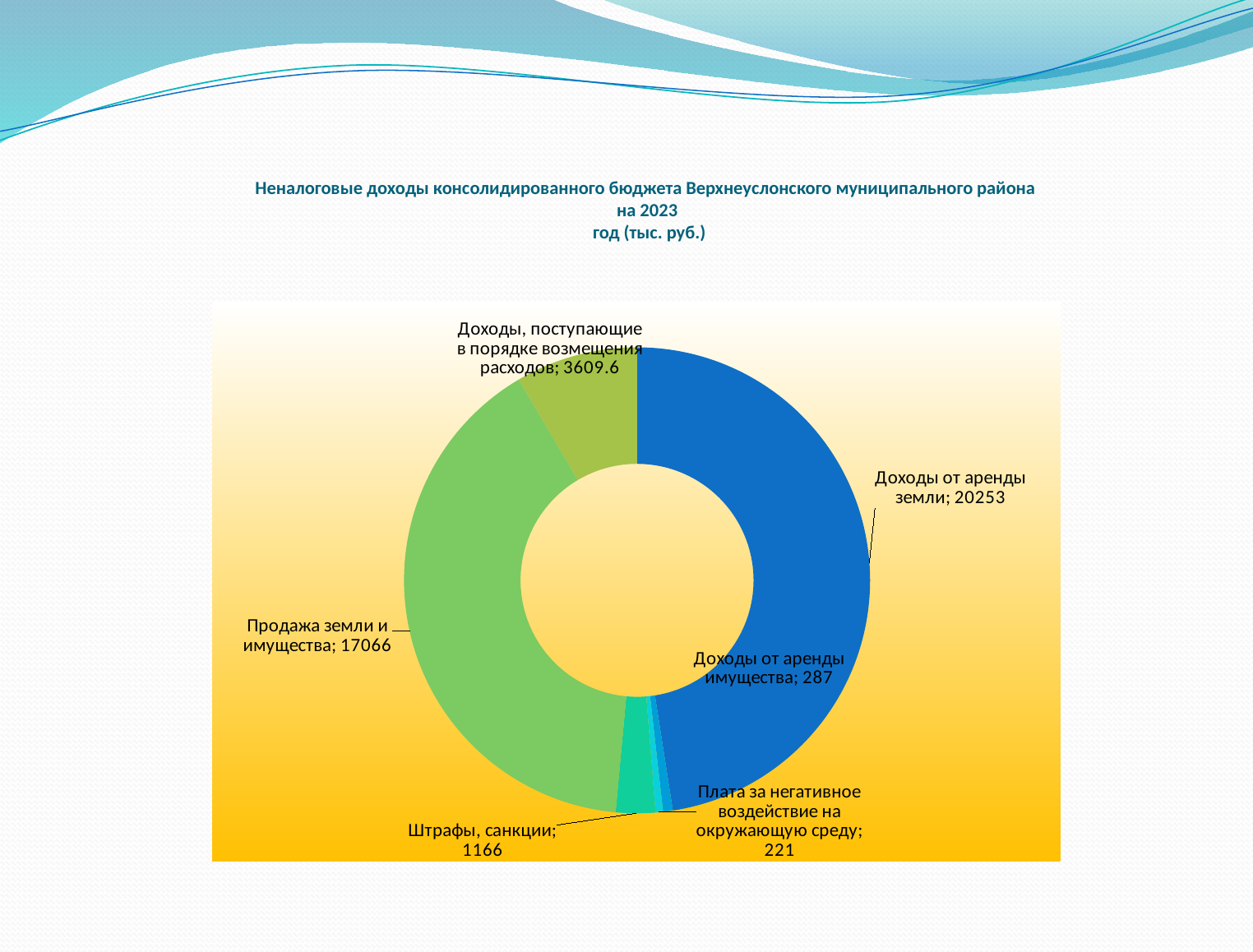
What is the value for Доходы, поступающие в порядке возмещения расходов? 3609.6 How many categories are shown in the chart? 6 What is the value for Продажа земли и имущества? 17066 What is the value for Плата за негативное воздействие на окружающую среду? 221 Which category has the highest value? Доходы от аренды земли What is the value for Доходы от аренды земли? 20253 What is the value for Штрафы, санкции? 1166 What kind of chart is shown on the slide? doughnut chart Which category has the lowest value? Плата за негативное воздействие на окружающую среду Which is larger: Доходы, поступающие в порядке возмещения расходов or Штрафы, санкции? Доходы, поступающие в порядке возмещения расходов What is the difference between Штрафы, санкции and Доходы от аренды имущества? 879 What is the difference between Доходы от аренды земли and Продажа земли и имущества? 3187